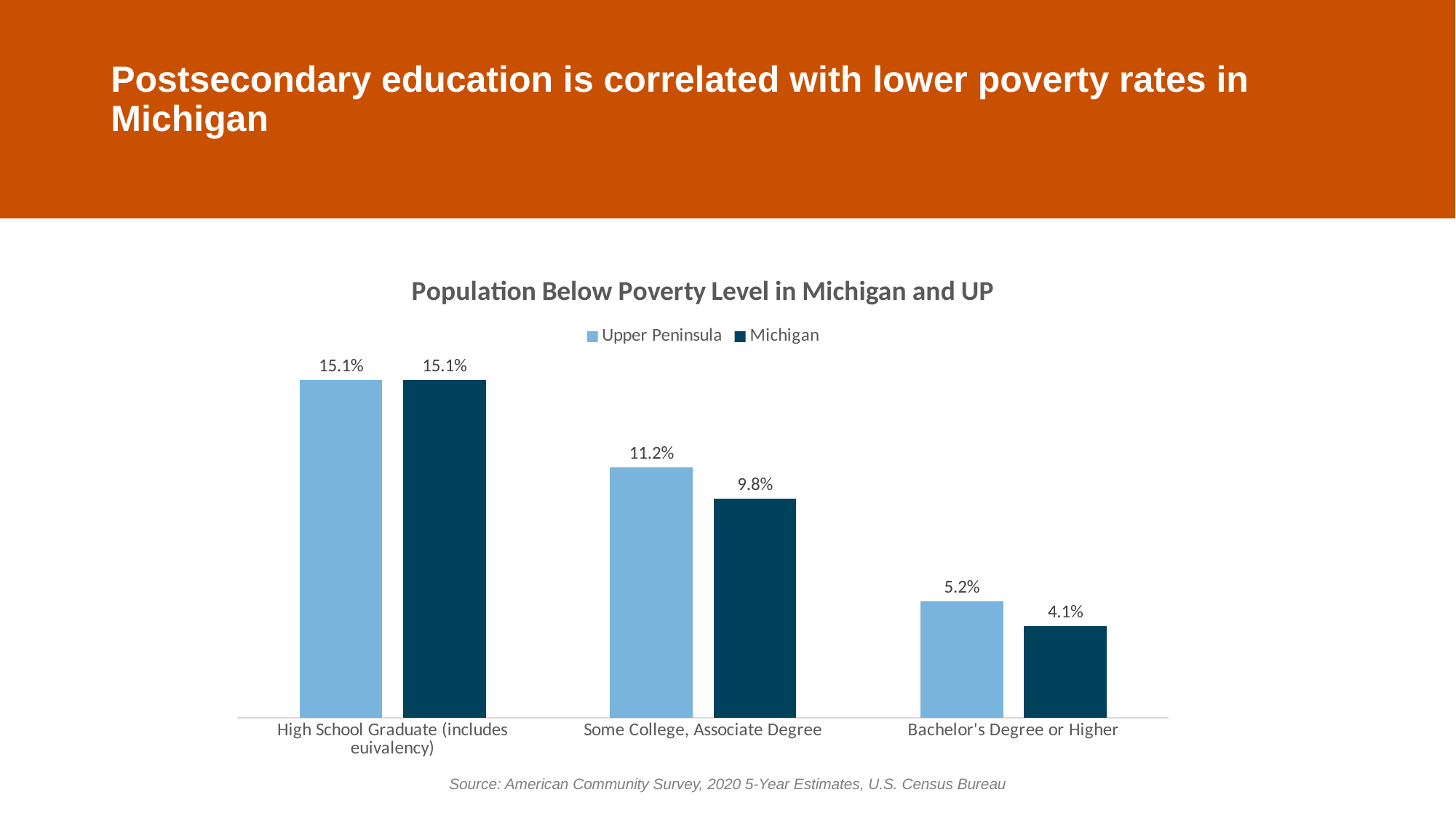
How many series does the legend list? 2 What is the difference between the Upper Peninsula and Michigan values for Some College, Associate Degree? 1.4% What is the Upper Peninsula value for High School Graduate (includes euivalency)? 15.1% Which category has the lowest Michigan value? Bachelor's Degree or Higher How many categories are shown on the x axis? 3 What is the Michigan value for Bachelor's Degree or Higher? 4.1% For Bachelor's Degree or Higher, which is larger: the Upper Peninsula value or the Michigan value? Upper Peninsula What kind of chart is shown on the slide? Bar chart What is the Michigan value for Some College, Associate Degree? 9.8% Which category has the highest Upper Peninsula value? High School Graduate (includes euivalency) What is the Upper Peninsula value for Some College, Associate Degree? 11.2% What is the difference between the Upper Peninsula and Michigan values for Bachelor's Degree or Higher? 1.1%